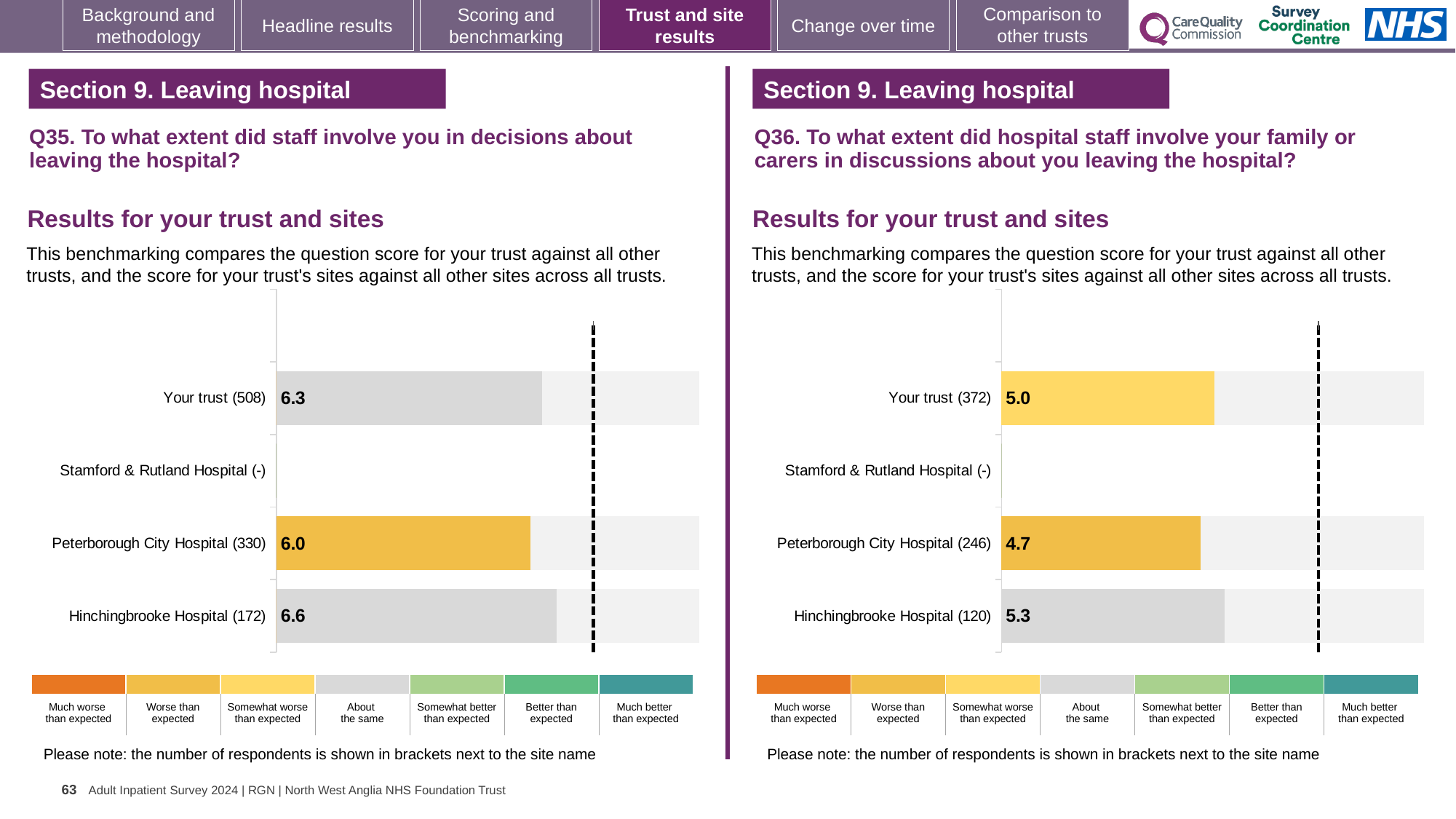
In the Q36 chart on the right, which site or trust has the lowest score? Peterborough City Hospital In the Q36 chart on the right, what is the score for Your trust? 5.0 In the Q35 chart on the left, what is the difference between the scores for Hinchingbrooke Hospital and Peterborough City Hospital? 0.6 In the Q36 chart on the right, which benchmark category does the colour of the Peterborough City Hospital bar correspond to? Worse than expected In the Q36 chart on the right, is the score for Your trust larger or smaller than the score for Peterborough City Hospital? larger In the Q35 chart on the left, what is the score for Your trust? 6.3 What type of chart is used for the Q35 results on the left? bar chart In the Q35 chart on the left, which site or trust has the highest score? Hinchingbrooke Hospital How many respondents are shown in brackets for Your trust in the Q36 chart on the right? 372 In the Q36 chart on the right, what is the difference between the scores for Your trust and Peterborough City Hospital? 0.3 In the Q35 chart on the left, what is the score for Peterborough City Hospital? 6.0 In the Q36 chart on the right, what is the score for Hinchingbrooke Hospital? 5.3